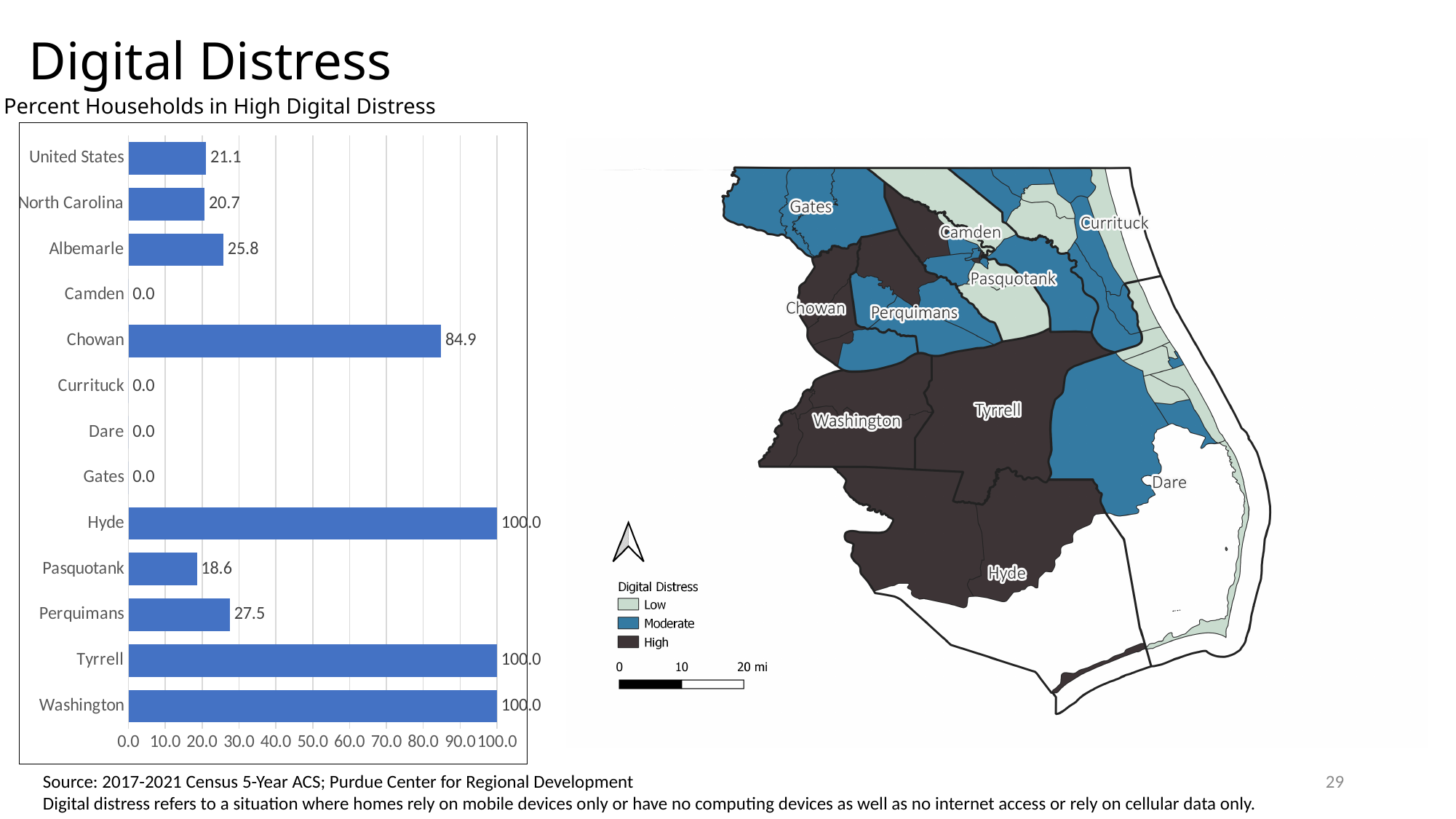
What kind of chart is shown on the left of the slide? Bar chart What is the value for North Carolina in the bar chart? 20.7 What is the value for Chowan in the bar chart? 84.9 In the bar chart, what is the difference between the values for Perquimans and Pasquotank? 8.9 How many categories in the bar chart have a value of 100.0? 3 How many categories are shown in the bar chart? 13 What is the value for Albemarle in the bar chart? 25.8 In the bar chart, what is the difference between the values for Chowan and Albemarle? 59.1 In the bar chart, is the value for Chowan greater or less than 80.0? greater What is the value for Pasquotank in the bar chart? 18.6 In the bar chart, which has the larger value, Perquimans or Albemarle? Perquimans What is the title of the bar chart? Percent Households in High Digital Distress